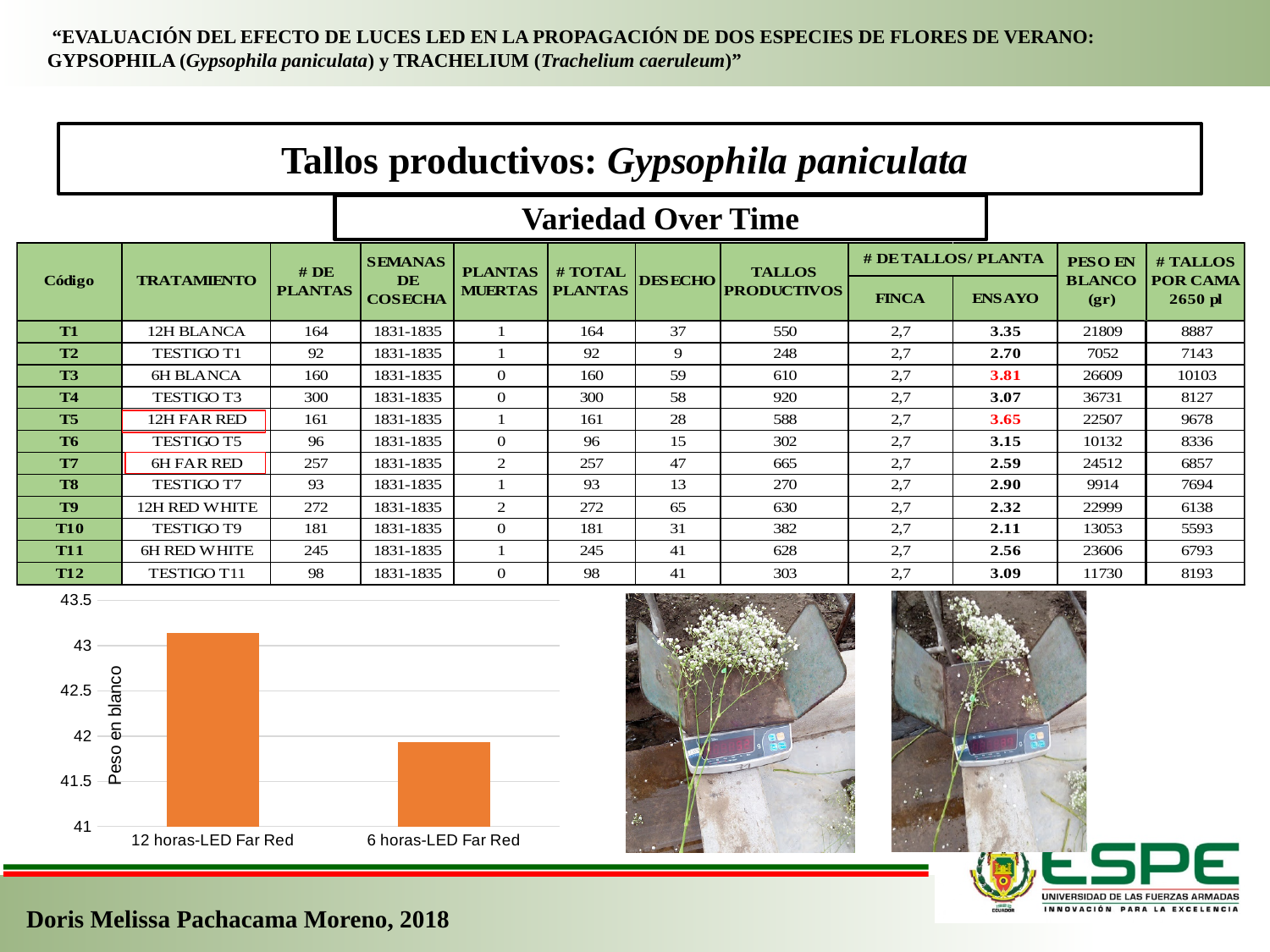
What is the lowest value shown on the vertical axis of the bar chart? 41 Do the values in the bar chart rise or fall from left to right? fall Which category has the lowest value in the bar chart? 6 horas-LED Far Red Which category has the highest value in the bar chart? 12 horas-LED Far Red How many bars does the chart at the bottom left of the slide have? 2 In the bar chart, which is larger: the value for 12 horas-LED Far Red or the value for 6 horas-LED Far Red? 12 horas-LED Far Red In the bar chart, is the value for 6 horas-LED Far Red greater or less than 41.5? greater In the bar chart, is the value for 12 horas-LED Far Red greater or less than 42.5? greater What kind of chart is shown at the bottom left of the slide? bar chart In the bar chart, is the value for 6 horas-LED Far Red greater or less than 42.5? less What is the label of the vertical axis of the bar chart? Peso en blanco